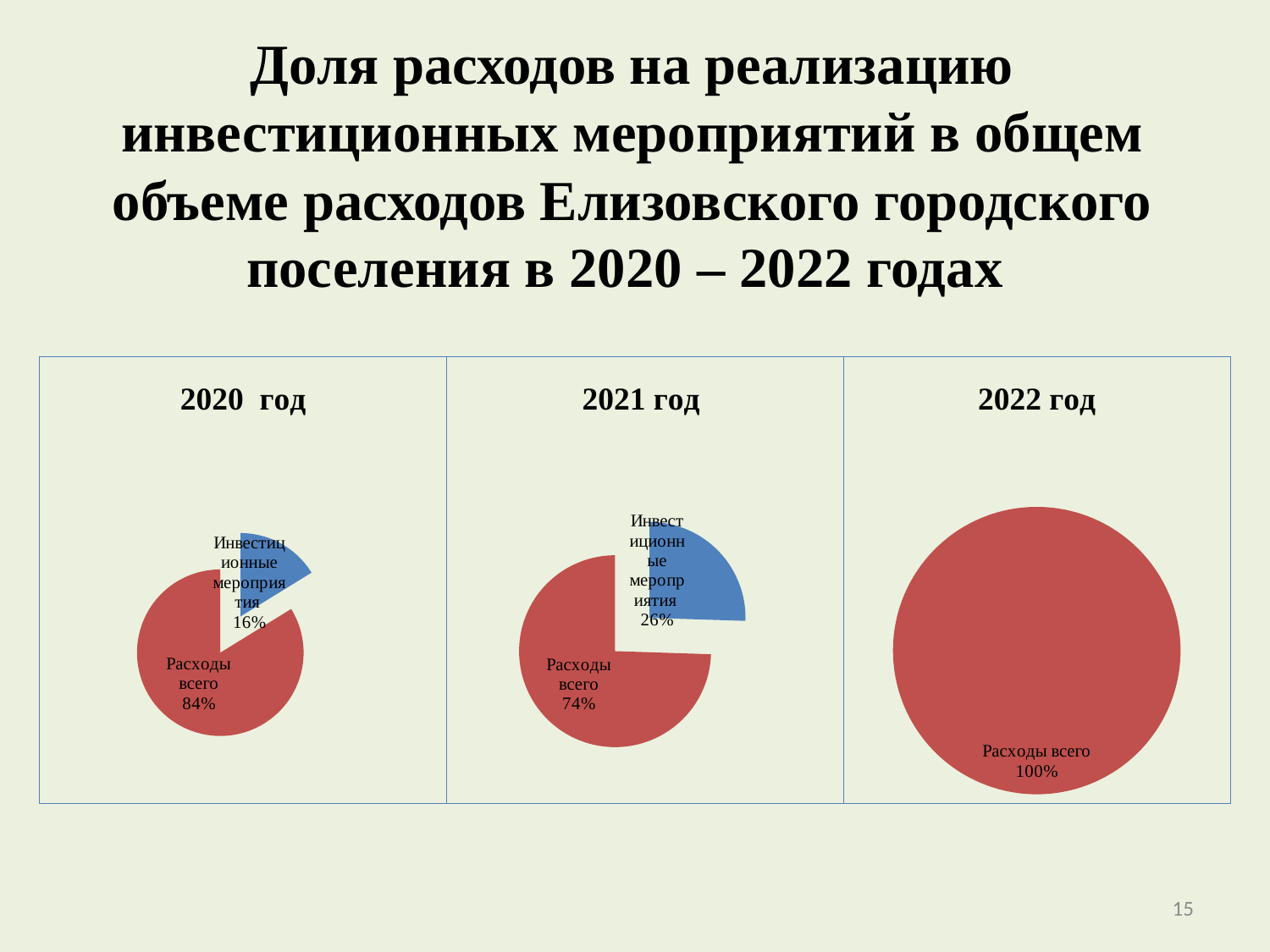
In the "2021 год" chart, what share is labelled for "Инвестиционные мероприятия"? 26% In the "2021 год" chart, what share is labelled for "Расходы всего"? 74% In the "2020 год" chart, what share is labelled for "Расходы всего"? 84% How many pie charts are shown on the slide? 3 Is the share of "Инвестиционные мероприятия" larger in the "2020 год" chart or the "2021 год" chart? 2021 год In the "2021 год" chart, which slice is the smallest? Инвестиционные мероприятия How many slices does the "2022 год" chart have? 1 What is the difference between the "Расходы всего" share in the "2020 год" chart and in the "2021 год" chart? 10% In the "2020 год" chart, which slice is the largest? Расходы всего What kind of chart is the "2021 год" chart? Pie chart